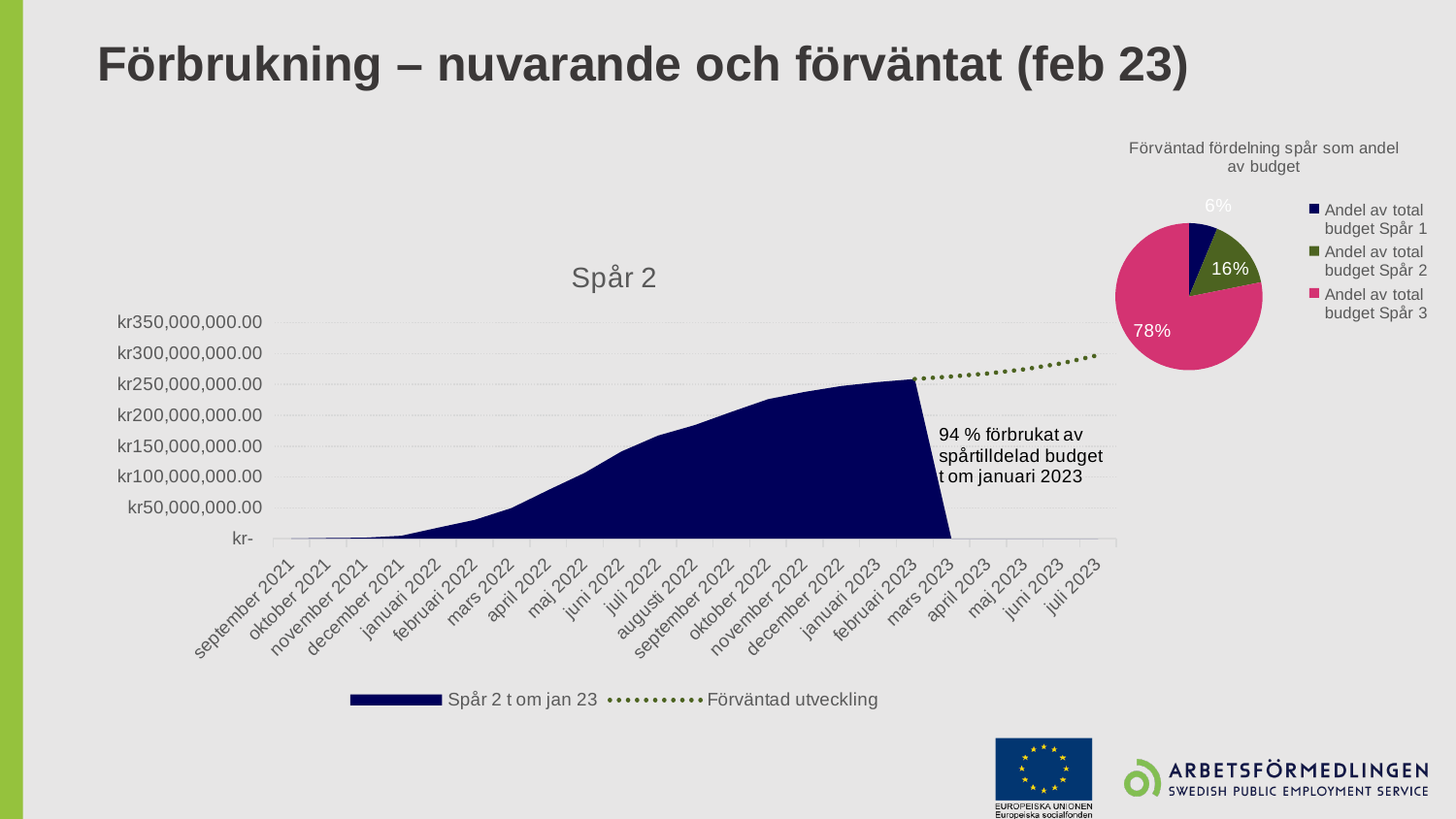
In the pie chart 'Förväntad fördelning spår som andel av budget', how many entries does the legend list? 3 In the pie chart 'Förväntad fördelning spår som andel av budget', what share is 'Andel av total budget Spår 1'? 6% In the pie chart 'Förväntad fördelning spår som andel av budget', which slice is the largest? Andel av total budget Spår 3 In the chart titled 'Spår 2', is the value for december 2022 greater or less than kr200,000,000.00? greater In the pie chart 'Förväntad fördelning spår som andel av budget', what share is 'Andel av total budget Spår 2'? 16% In the chart titled 'Spår 2', how many series does the legend list? 2 In the pie chart 'Förväntad fördelning spår som andel av budget', what is the difference in percentage points between Spår 3 and Spår 2? 62 percentage points In the pie chart 'Förväntad fördelning spår som andel av budget', which slice is the smallest? Andel av total budget Spår 1 In the pie chart 'Förväntad fördelning spår som andel av budget', what share is 'Andel av total budget Spår 3'? 78% What kind of chart is the chart titled 'Spår 2'? Area chart In the chart titled 'Spår 2', does the 'Spår 2 t om jan 23' series rise or fall from september 2021 to januari 2023? Rise